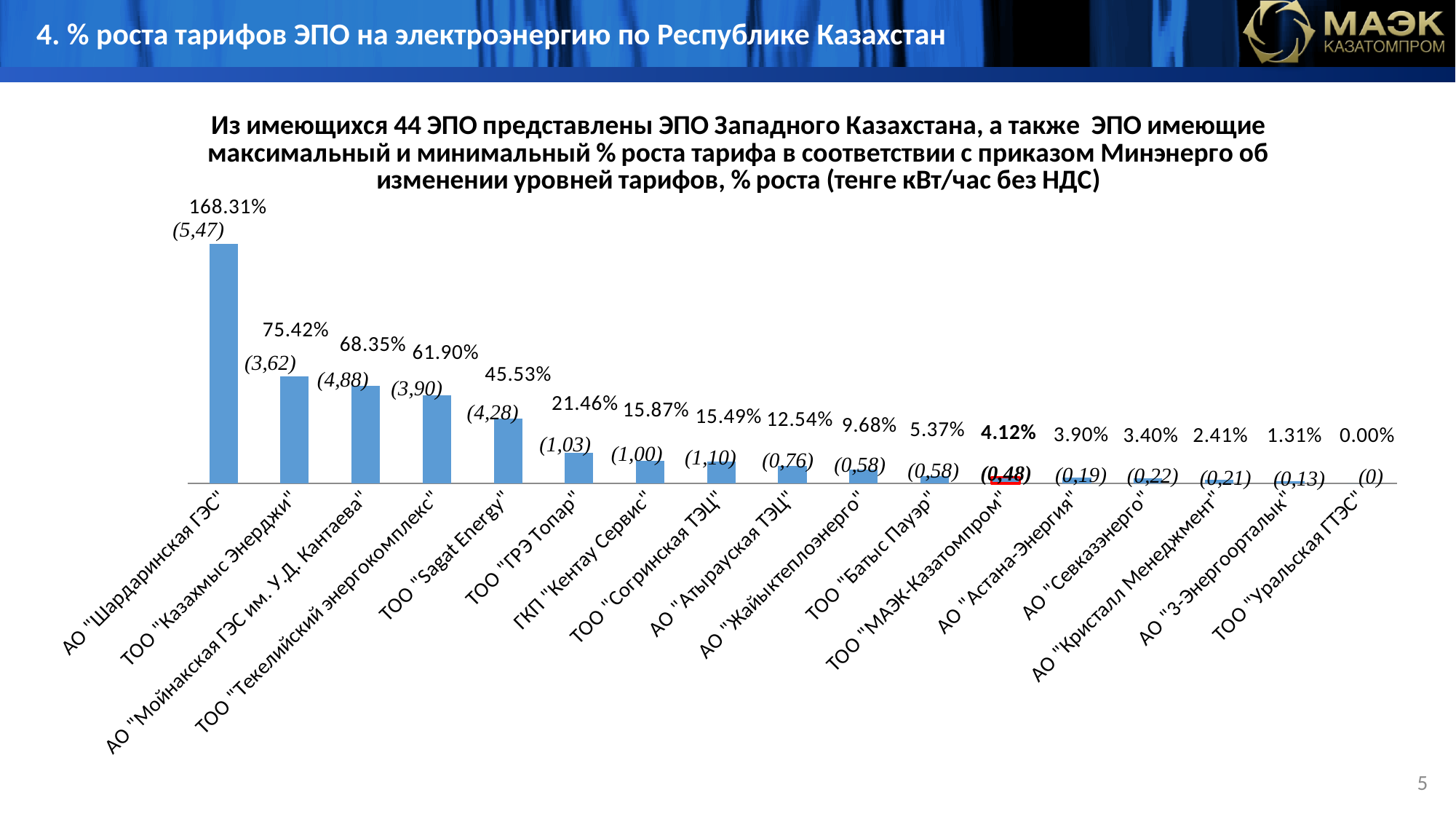
Which has a larger % growth value: ТОО "ГРЭ Топар" or ГКП "Кентау Сервис"? ТОО "ГРЭ Топар" What value in parentheses is shown for ТОО "Казахмыс Энерджи"? (3,62) What is the % growth value shown for ТОО "Sagat Energy"? 45.53% How many categories (ЭПО) are plotted in the chart? 17 Do the values rise or fall moving from left to right along the x axis? fall Which category has the highest % growth value? АО "Шардаринская ГЭС" What is the % growth value shown for ТОО "МАЭК-Казатомпром"? 4.12% Which category has the lowest % growth value? ТОО "Уральская ГТЭС" What is the difference between the % growth values of ТОО "Казахмыс Энерджи" and АО "Мойнакская ГЭС им. У.Д. Кантаева"? 7.07% What type of chart is shown on the slide? bar chart What is the % growth value shown for АО "Шардаринская ГЭС"? 168.31% What is the % growth value shown for АО "Атырауская ТЭЦ"? 12.54%